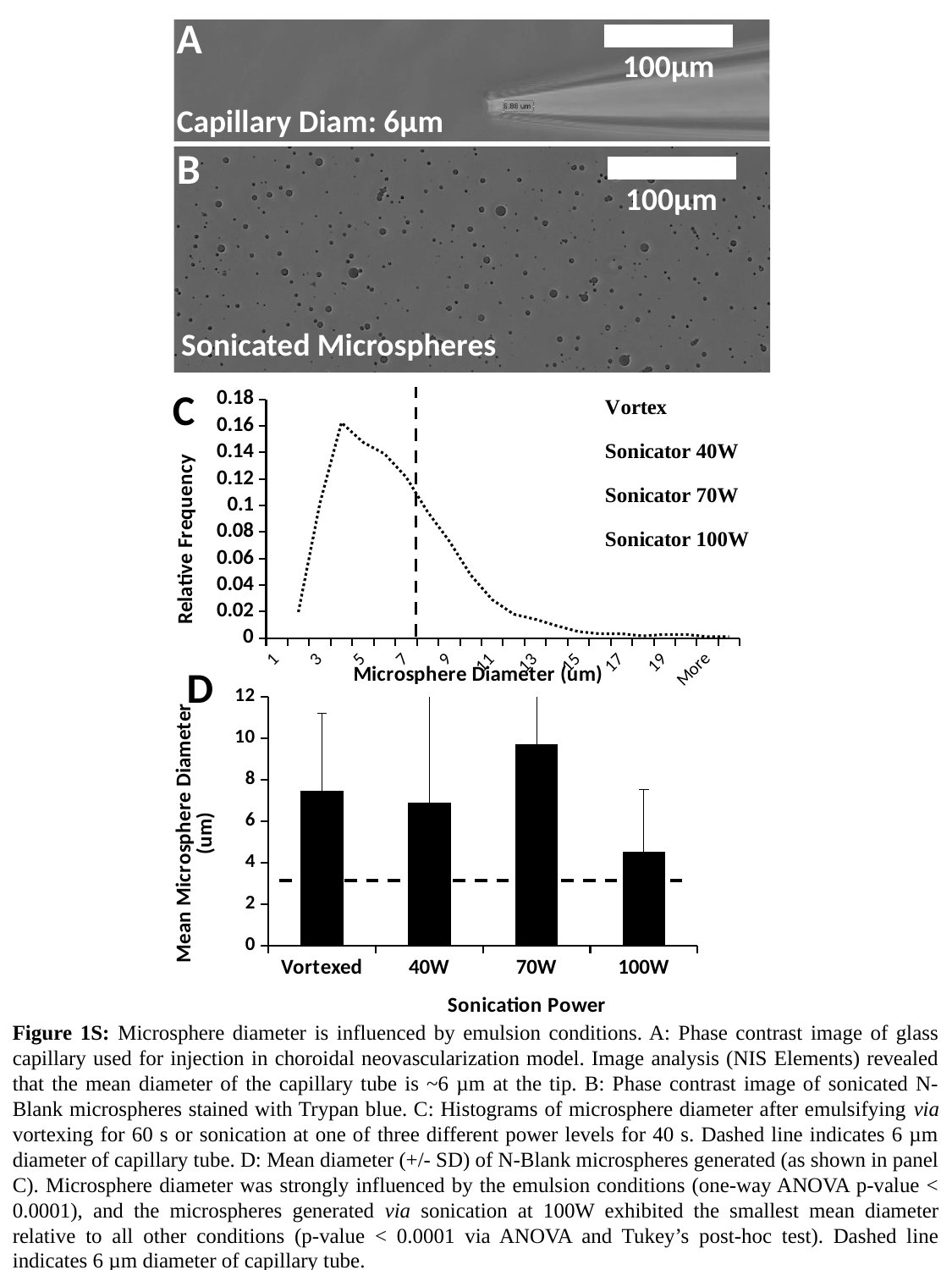
How many series does the legend of chart C list? 4 In chart C, is the peak relative frequency of the plotted curve greater or less than 0.14? greater In chart D, is the mean microsphere diameter for Vortexed greater or less than 6? greater What kind of chart is chart D? bar chart How many sonication power categories are shown on the x axis of chart D? 4 In chart D, is the mean microsphere diameter for 100W greater or less than 6? less What is the y-axis title of chart C? Relative Frequency In chart D, which has the larger mean microsphere diameter, 70W or 100W? 70W In chart D, which condition has the lowest mean microsphere diameter? 100W In chart D, which sonication power condition has the highest mean microsphere diameter? 70W What is the x-axis title of chart D? Sonication Power